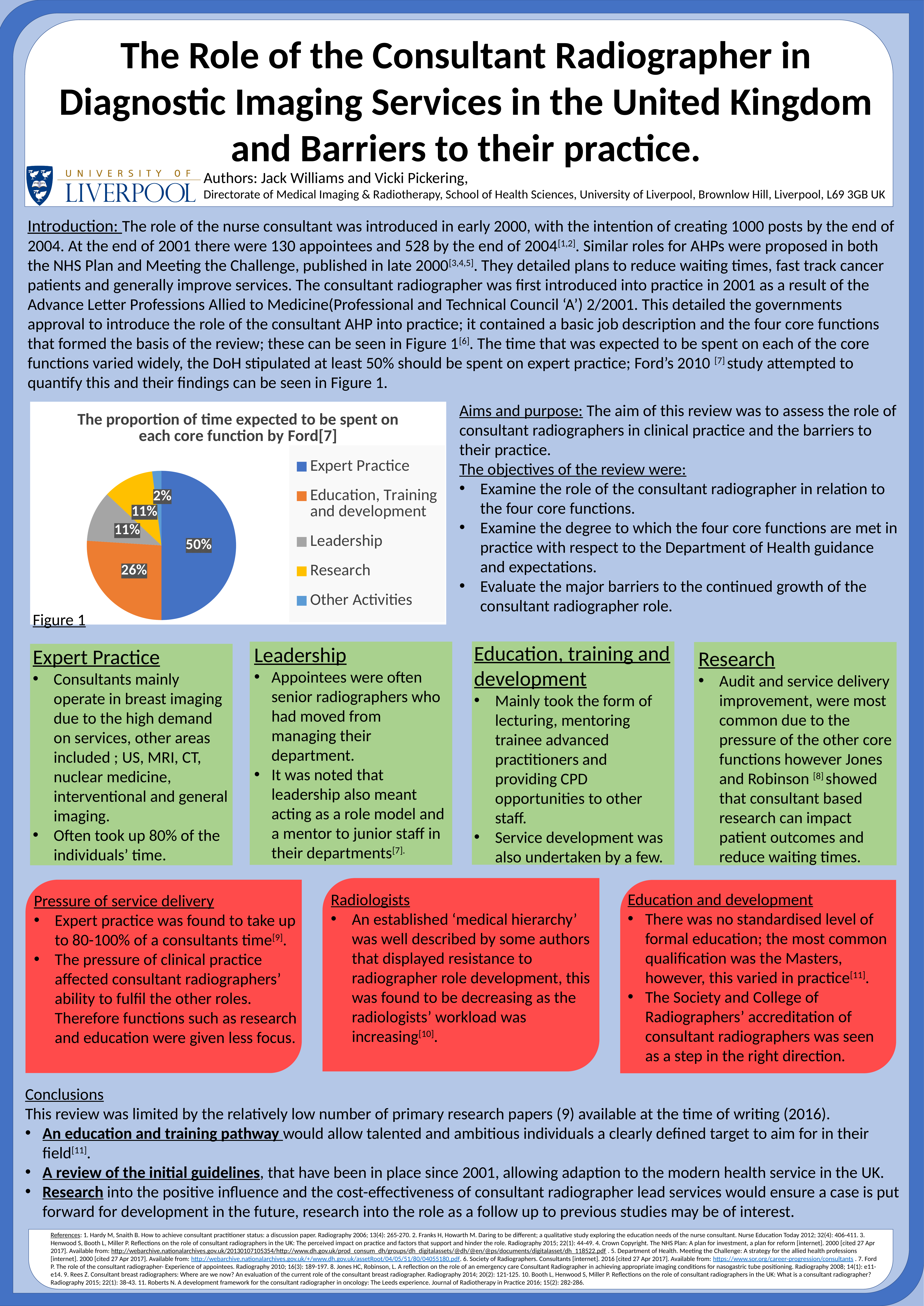
What percentage of time is expected to be spent on Leadership? 11% Which category has the smallest share of the pie? Other Activities Which has a larger share: Education, Training and development or Research? Education, Training and development What percentage of time is expected to be spent on Other Activities? 2% What percentage of time is expected to be spent on Expert Practice? 50% What is the title of the chart in Figure 1? The proportion of time expected to be spent on each core function by Ford[7] Which core function has the largest share of expected time? Expert Practice What is the difference in percentage points between Expert Practice and Education, Training and development? 24 What kind of chart is shown in Figure 1? pie chart What colour is the Research slice in the pie chart? yellow How many categories does the legend of the pie chart list? 5 What percentage of time is expected to be spent on Education, Training and development? 26%